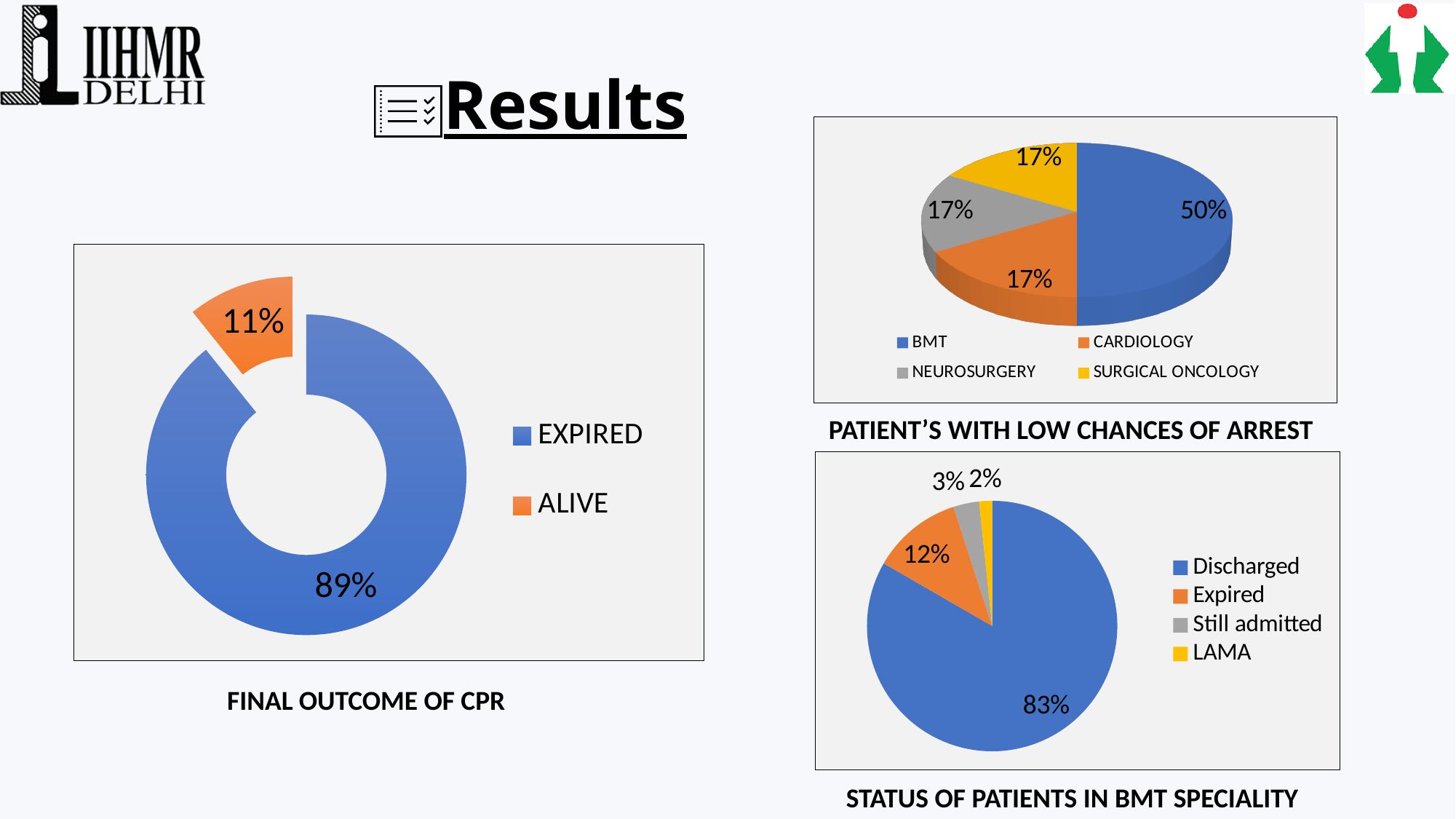
In the PATIENT'S WITH LOW CHANCES OF ARREST chart, which category has the largest share? BMT In the STATUS OF PATIENTS IN BMT SPECIALITY chart, what share of patients were discharged? 83% In the PATIENT'S WITH LOW CHANCES OF ARREST chart, what share is BMT? 50% How many categories does the legend of the PATIENT'S WITH LOW CHANCES OF ARREST chart list? 4 In the FINAL OUTCOME OF CPR chart, what share of patients were alive? 11% In the FINAL OUTCOME OF CPR chart, what share of patients expired? 89% In the FINAL OUTCOME OF CPR chart, what is the difference between the EXPIRED and ALIVE shares? 78% In the PATIENT'S WITH LOW CHANCES OF ARREST chart, what share is CARDIOLOGY? 17% In the STATUS OF PATIENTS IN BMT SPECIALITY chart, which is larger: Expired or Still admitted? Expired What kind of chart is the FINAL OUTCOME OF CPR chart? Donut chart In the STATUS OF PATIENTS IN BMT SPECIALITY chart, which category has the smallest share? LAMA In the STATUS OF PATIENTS IN BMT SPECIALITY chart, what colour is the Still admitted slice? Grey